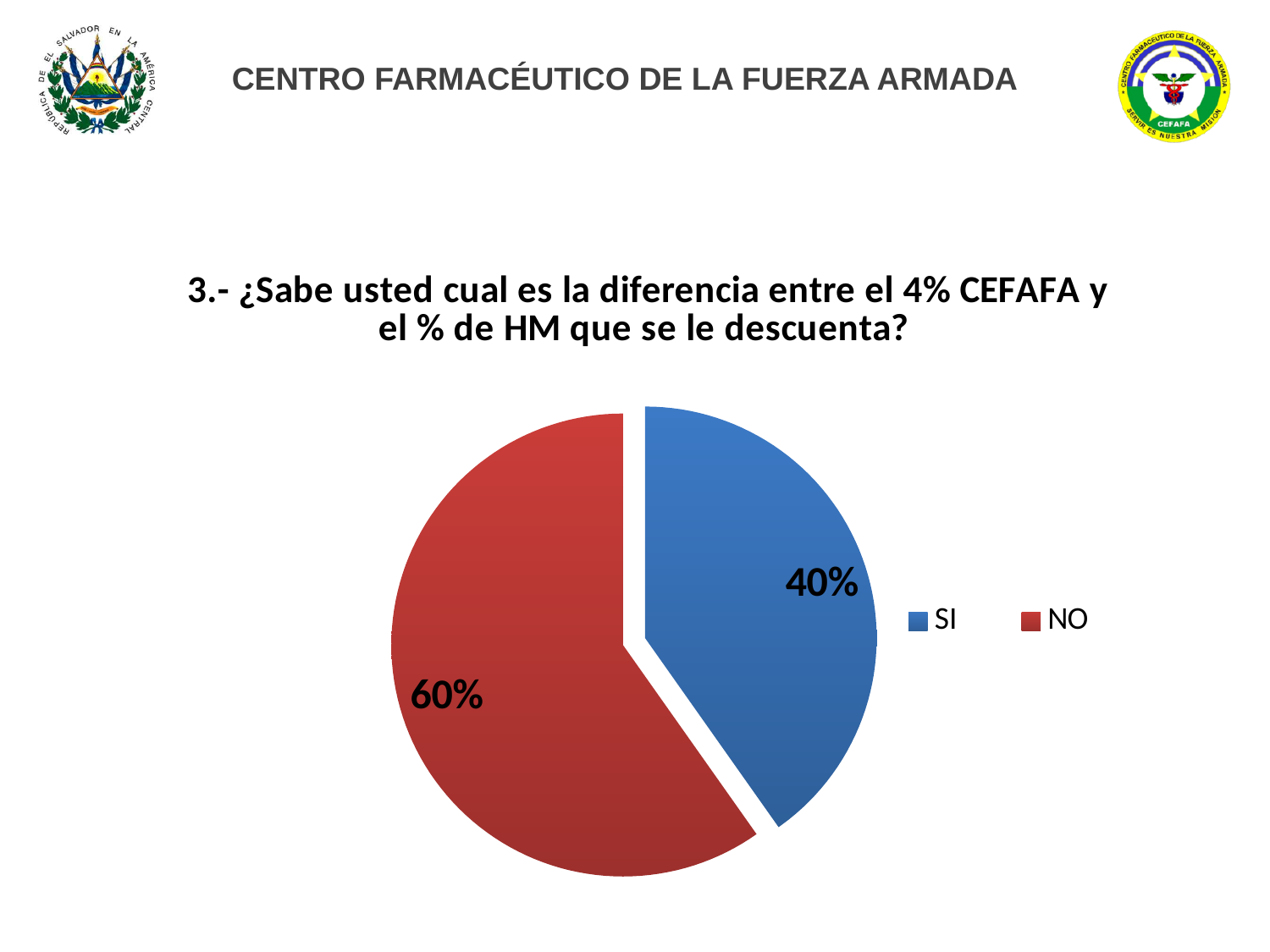
What is the difference in percentage points between the NO and SI slices? 20% How many slices does the pie chart have? 2 What share of the pie does the SI slice represent? 40% Which slice is larger, SI or NO? NO How many entries does the legend list? 2 Which response has the smallest share of the pie? SI What colour is the SI slice? blue What percentage of respondents answered NO? 60% Which response has the largest share of the pie? NO What colour is the NO slice? red What percentage of respondents answered SI? 40% What kind of chart is shown on the slide? pie chart